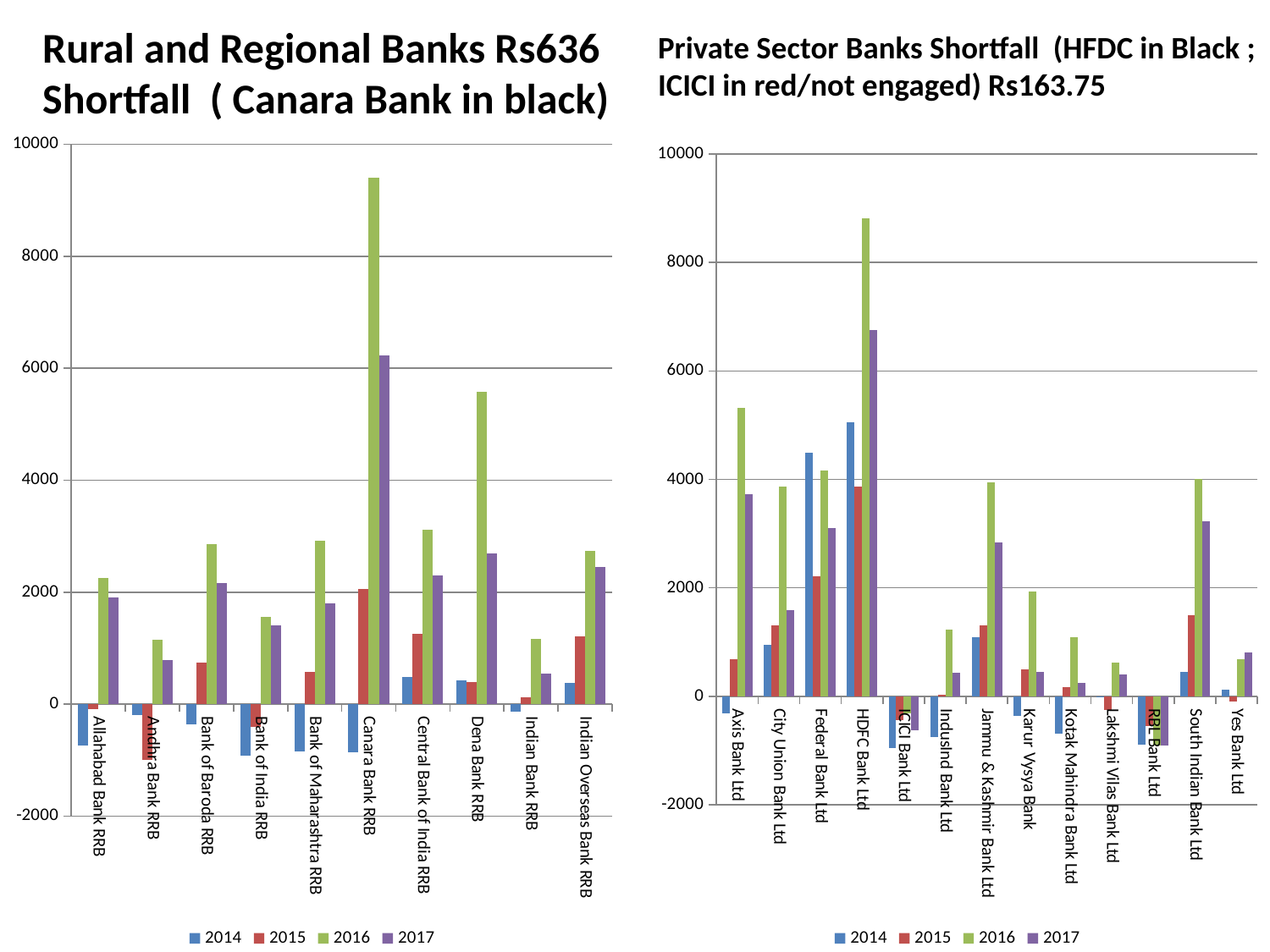
How many bank categories are shown on the 'Private Sector Banks Shortfall' chart on the right? 13 On the 'Rural and Regional Banks' chart, is the 2016 value for Canara Bank RRB greater or less than 8000? greater On the 'Private Sector Banks Shortfall' chart, is the 2014 value for HDFC Bank Ltd greater or less than 4000? greater How many bank categories are shown on the 'Rural and Regional Banks' chart on the left? 10 On the 'Rural and Regional Banks' chart, which bank has the highest 2016 value? Canara Bank RRB Which colour represents the 2016 series in the legend of the 'Rural and Regional Banks' chart? green How many series does the legend list on the 'Private Sector Banks Shortfall' chart? 4 On the 'Rural and Regional Banks' chart, is the 2016 value for Dena Bank RRB greater or less than 4000? greater On the 'Rural and Regional Banks' chart, which is larger: the 2016 value for Dena Bank RRB or the 2016 value for Central Bank of India RRB? Dena Bank RRB On the 'Private Sector Banks Shortfall' chart, which bank has the highest 2016 value? HDFC Bank Ltd On the 'Private Sector Banks Shortfall' chart, which is larger: the 2017 value for HDFC Bank Ltd or the 2017 value for Federal Bank Ltd? HDFC Bank Ltd What type of chart is the 'Rural and Regional Banks' chart on the left? bar chart